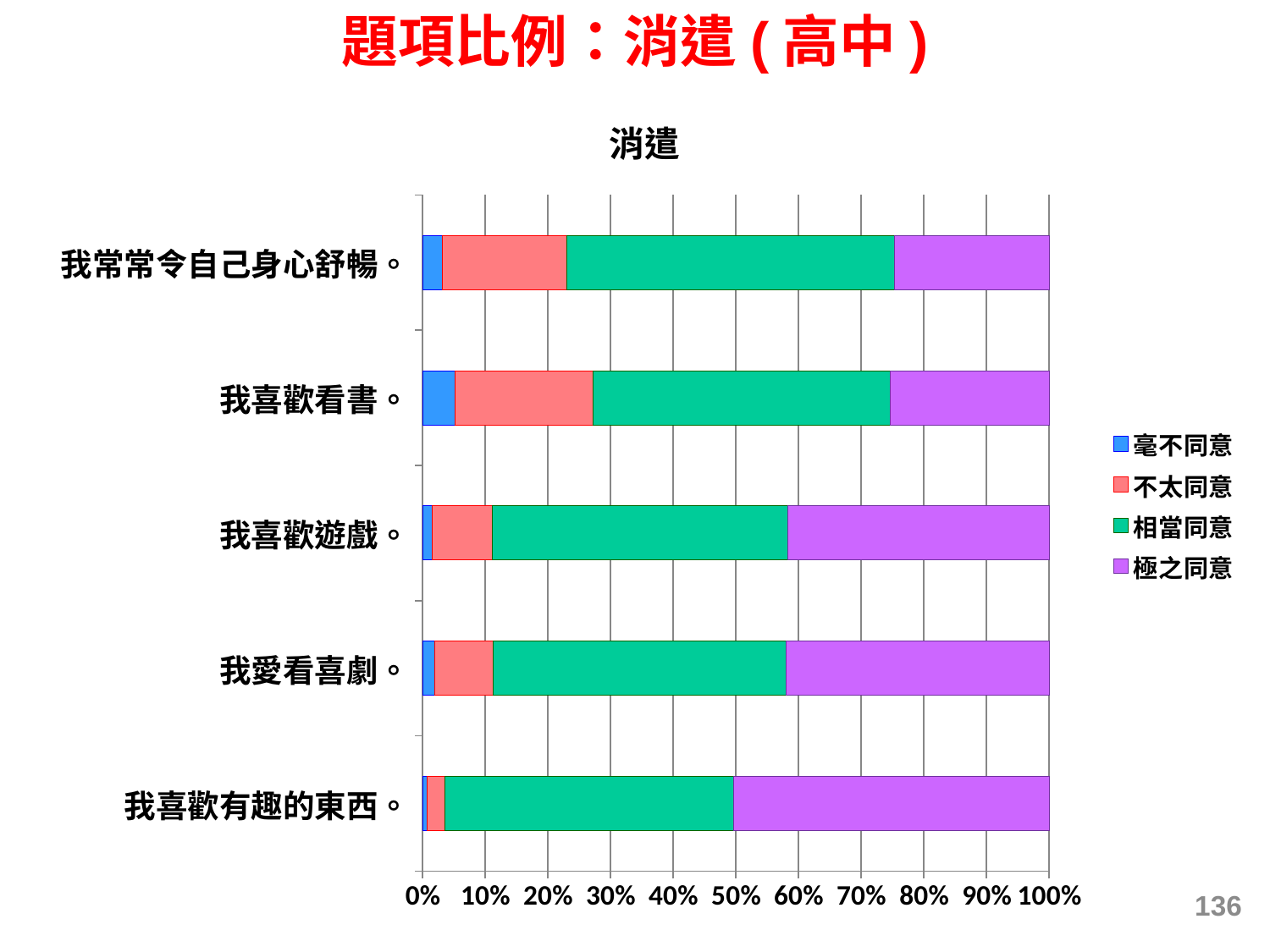
Which has the larger 極之同意 value: 我喜歡有趣的東西 or 我常常令自己身心舒暢? 我喜歡有趣的東西 How many categories (statements) are plotted on the chart? 5 Is the 不太同意 value for 我喜歡看書 greater or less than 10%? greater Is the 毫不同意 value for 我喜歡看書 greater or less than 10%? less Which statement has the smallest 不太同意 segment? 我喜歡有趣的東西 Which legend entry is shown in purple? 極之同意 How many series does the legend list? 4 What is the title of the chart? 消遣 Is the 極之同意 value for 我常常令自己身心舒暢 greater or less than 30%? less Which statement has the largest 極之同意 segment? 我喜歡有趣的東西 What kind of chart is shown on the slide? stacked bar chart